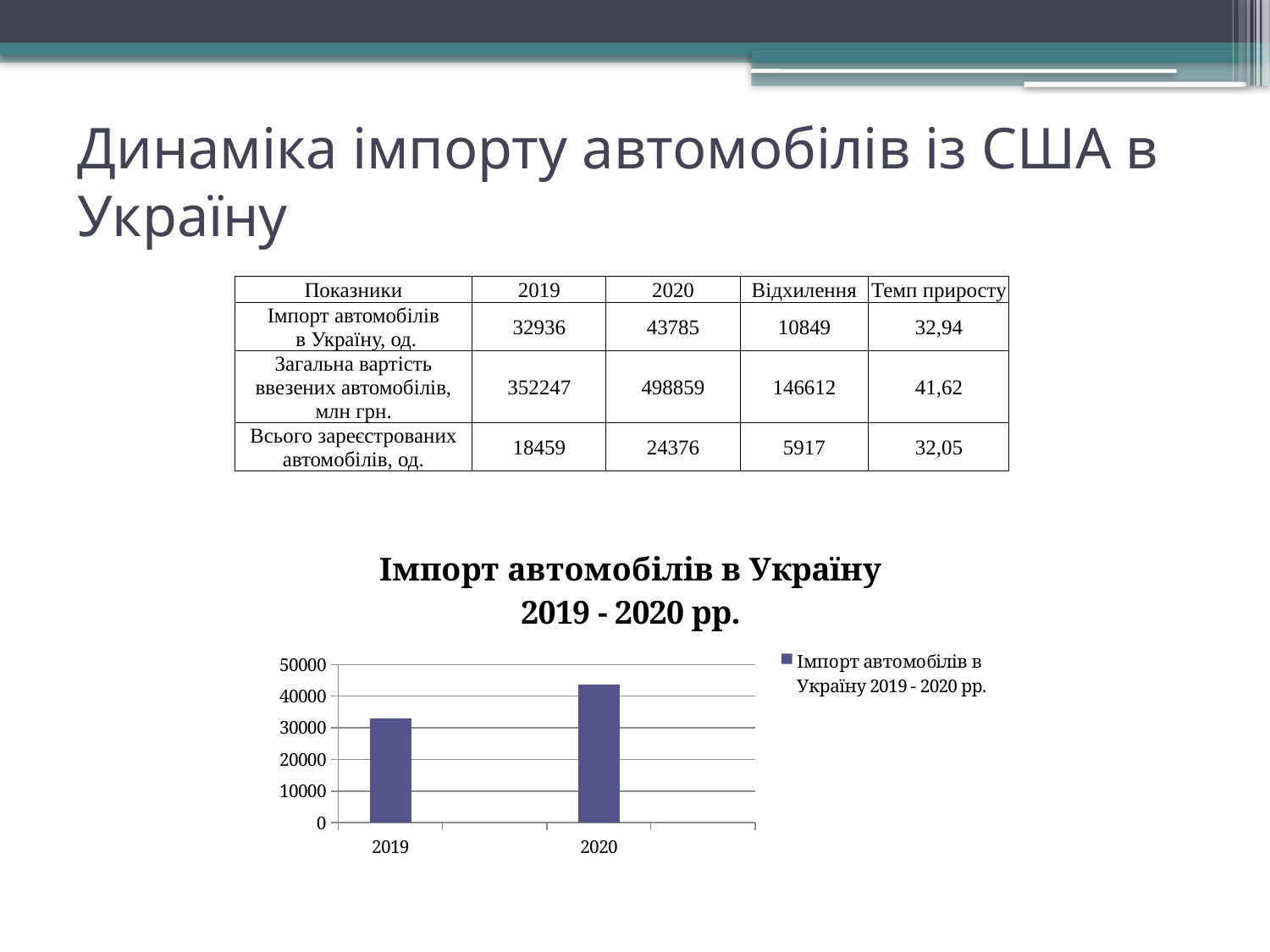
Is the value for 2020 greater or less than 50000? less How many categories are shown on the x axis of the chart? 2 Is the bar for 2020 larger or smaller than the bar for 2019? larger Which year has the lower bar in the chart? 2019 Is the value for 2019 greater or less than 30000? greater Is the value for 2020 greater or less than 40000? greater What kind of chart is shown on the slide? bar chart Which year has the higher bar in the chart? 2020 How many series does the chart legend list? 1 Do the values rise or fall from 2019 to 2020? rise What is the title of the chart? Імпорт автомобілів в Україну 2019 - 2020 рр.